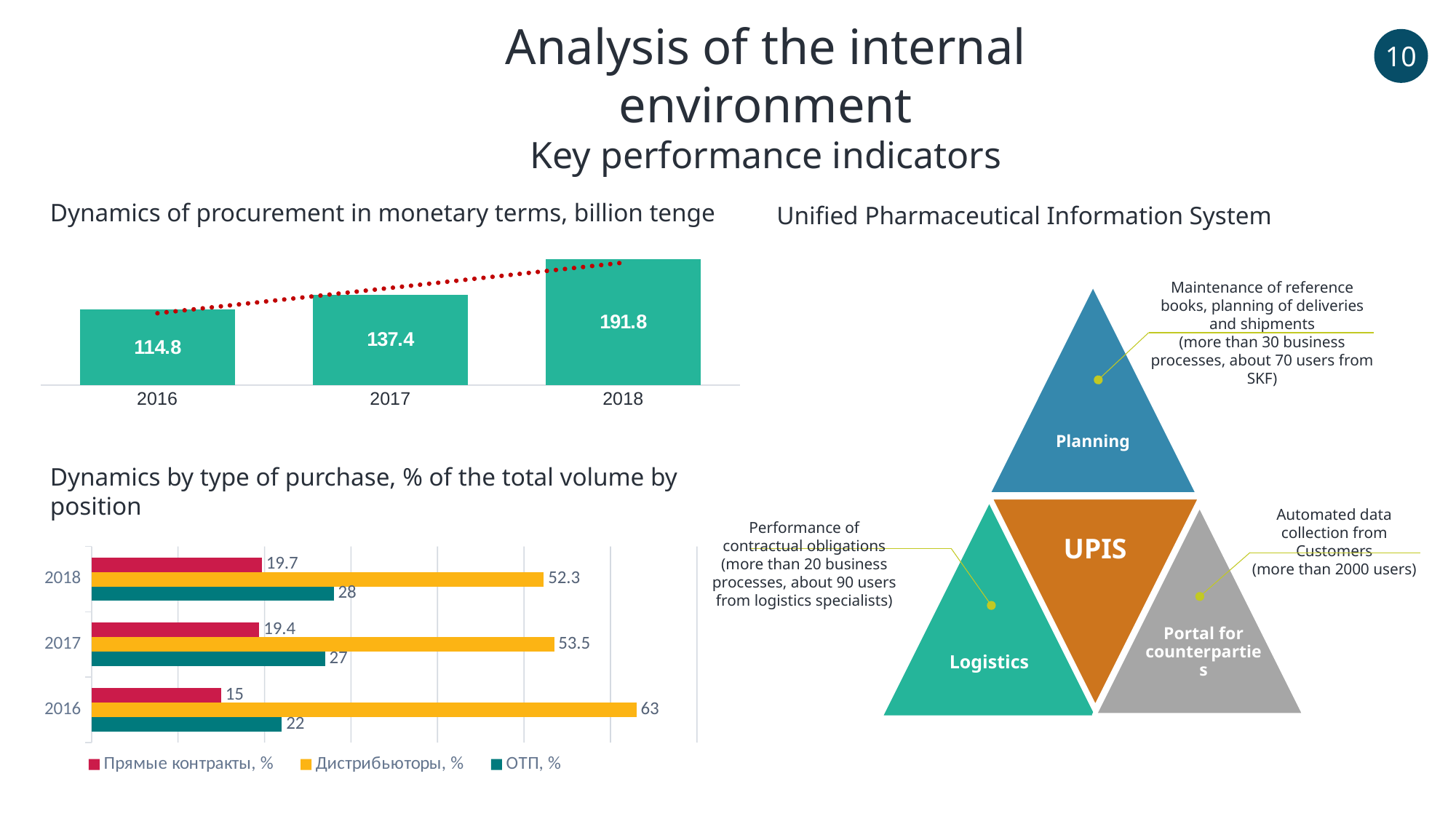
In the 'Dynamics by type of purchase' chart, what is the value for Дистрибьюторы, % in 2016? 63 In the 'Dynamics of procurement in monetary terms, billion tenge' chart, which year has the highest value? 2018 In the 'Dynamics of procurement in monetary terms, billion tenge' chart, how many years are shown? 3 What kind of chart is 'Dynamics by type of purchase, % of the total volume by position'? bar chart In the 'Dynamics of procurement in monetary terms, billion tenge' chart, do the values rise or fall from 2016 to 2018? rise In the 'Dynamics by type of purchase' chart, what is the value for ОТП, % in 2018? 28 In the 'Dynamics by type of purchase' chart, which year has the lowest value for Прямые контракты, %? 2016 In the 'Dynamics by type of purchase' chart, what is the difference between the Дистрибьюторы, % values for 2016 and 2018? 10.7 In the 'Dynamics of procurement in monetary terms, billion tenge' chart, what is the value for 2017? 137.4 In the 'Dynamics by type of purchase' chart, which is larger in 2017: Дистрибьюторы, % or ОТП, %? Дистрибьюторы, % In the 'Dynamics by type of purchase' chart, how many series does the legend list? 3 In the 'Dynamics of procurement in monetary terms, billion tenge' chart, what is the difference between the 2018 and 2016 values? 77